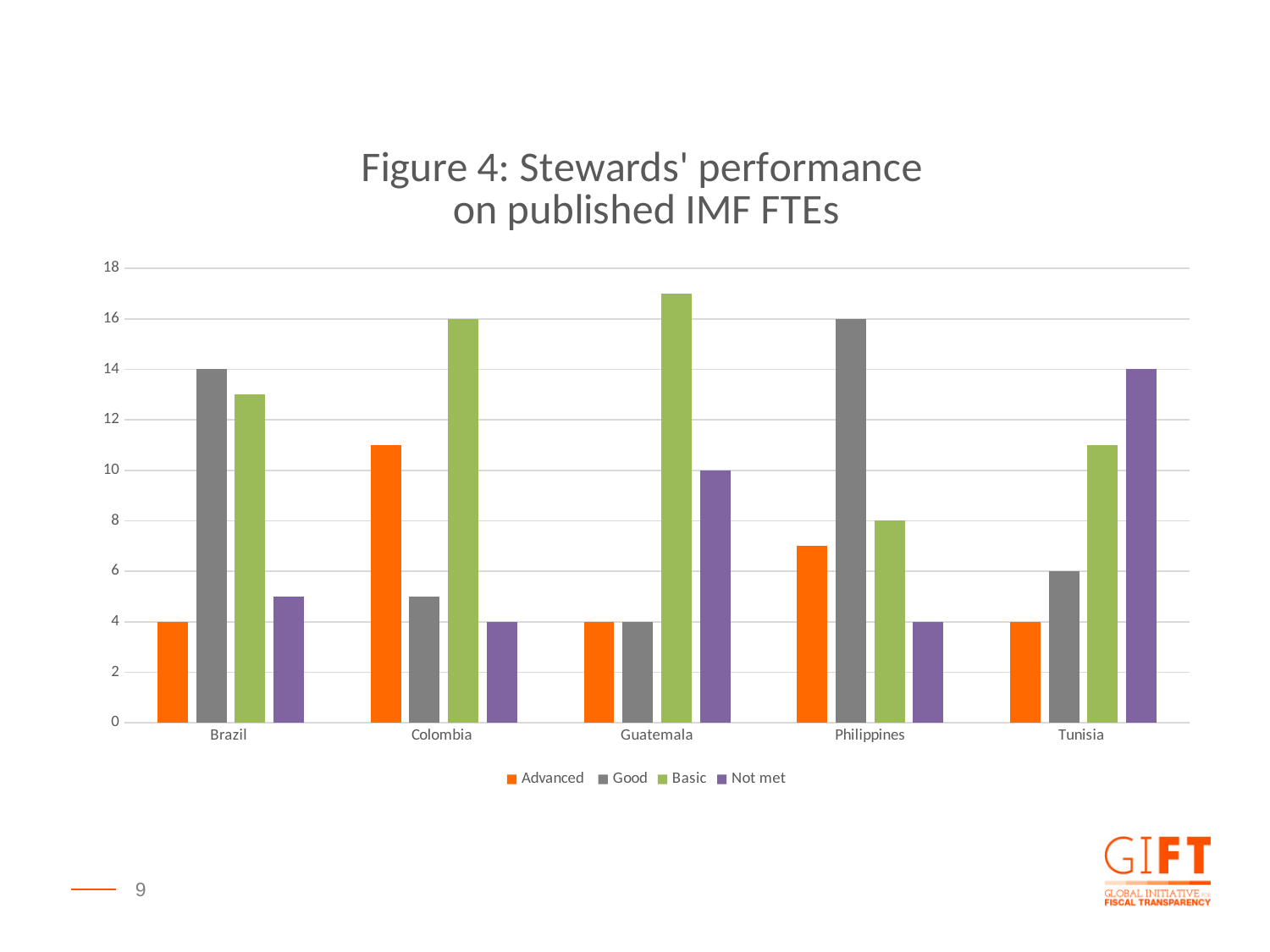
For Tunisia, which is larger: the Basic bar or the Not met bar? Not met How many countries are shown on the x axis? 5 What is the value of the Not met bar for Guatemala? 10 Which country has the highest Basic value? Guatemala What is the value of the Not met bar for Tunisia? 14 What is the difference between the Good and Basic values for the Philippines? 8 What is the value of the Basic bar for Colombia? 16 What kind of chart is shown on the slide? bar chart Is the Basic value for Guatemala greater or less than 16? greater How many series does the legend list? 4 Is the Advanced value for Colombia greater or less than 10? greater What is the value of the Good bar for Brazil? 14